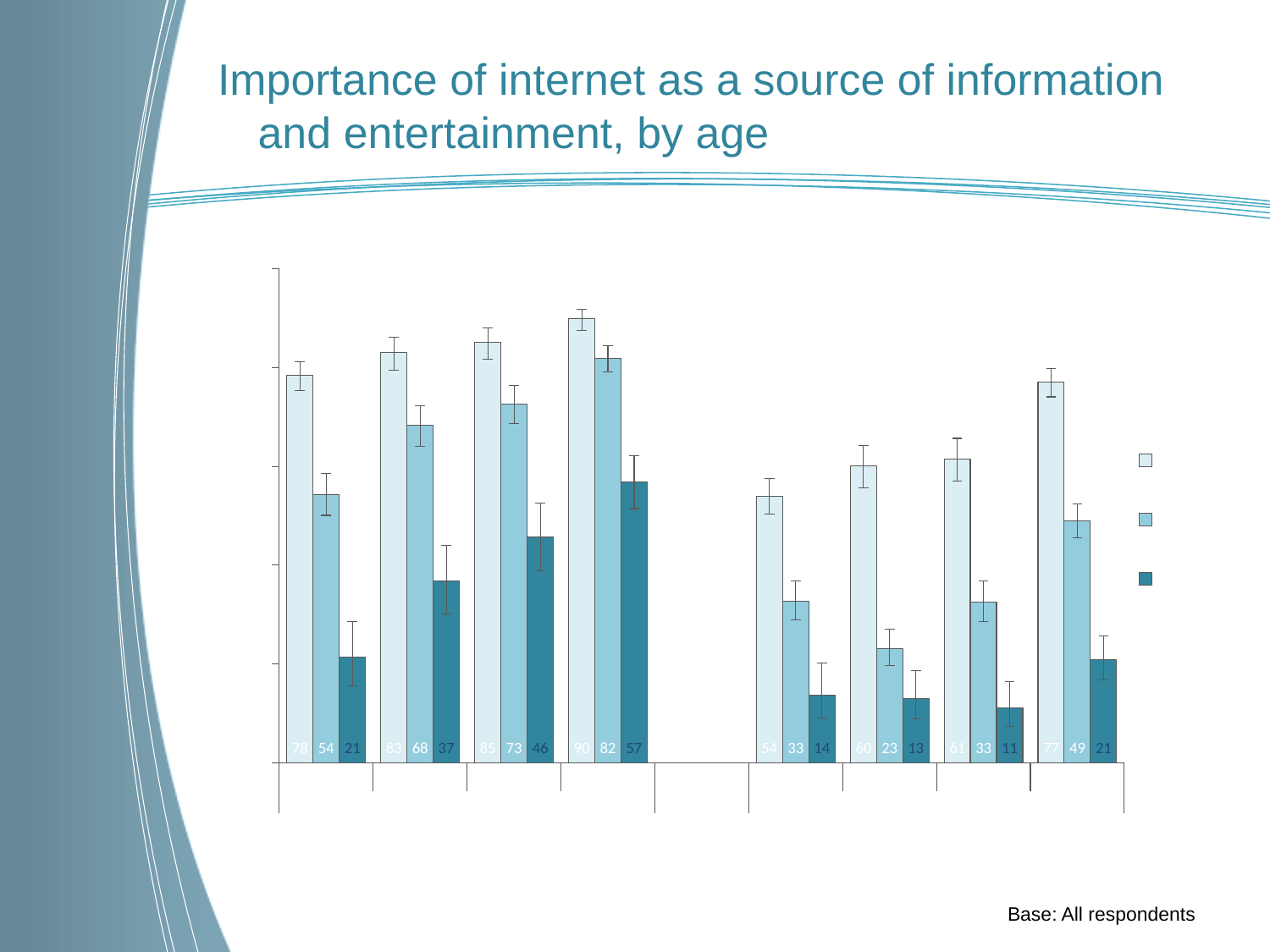
What is the value of the medium-blue bar in the rightmost group of bars? 49 What is the value of the darkest bar in the fourth group of bars from the left? 57 What is the lowest value labelled on any bar in the chart? 11 In the leftmost group of bars, what is the difference between the lightest bar (78) and the darkest bar (21)? 57 What type of chart is shown on the slide? bar chart How many groups of bars are plotted in the chart? 8 What is the title of the chart on the slide? Importance of internet as a source of information and entertainment, by age How many series does the legend on the right of the chart show? 3 What base note is printed at the bottom right of the slide? Base: All respondents What is the highest value labelled on any bar in the chart? 90 What is the value of the lightest bar in the leftmost group of bars? 78 Which is larger: the lightest bar in the third group from the left (85) or the lightest bar in the rightmost group (77)? the third group (85)